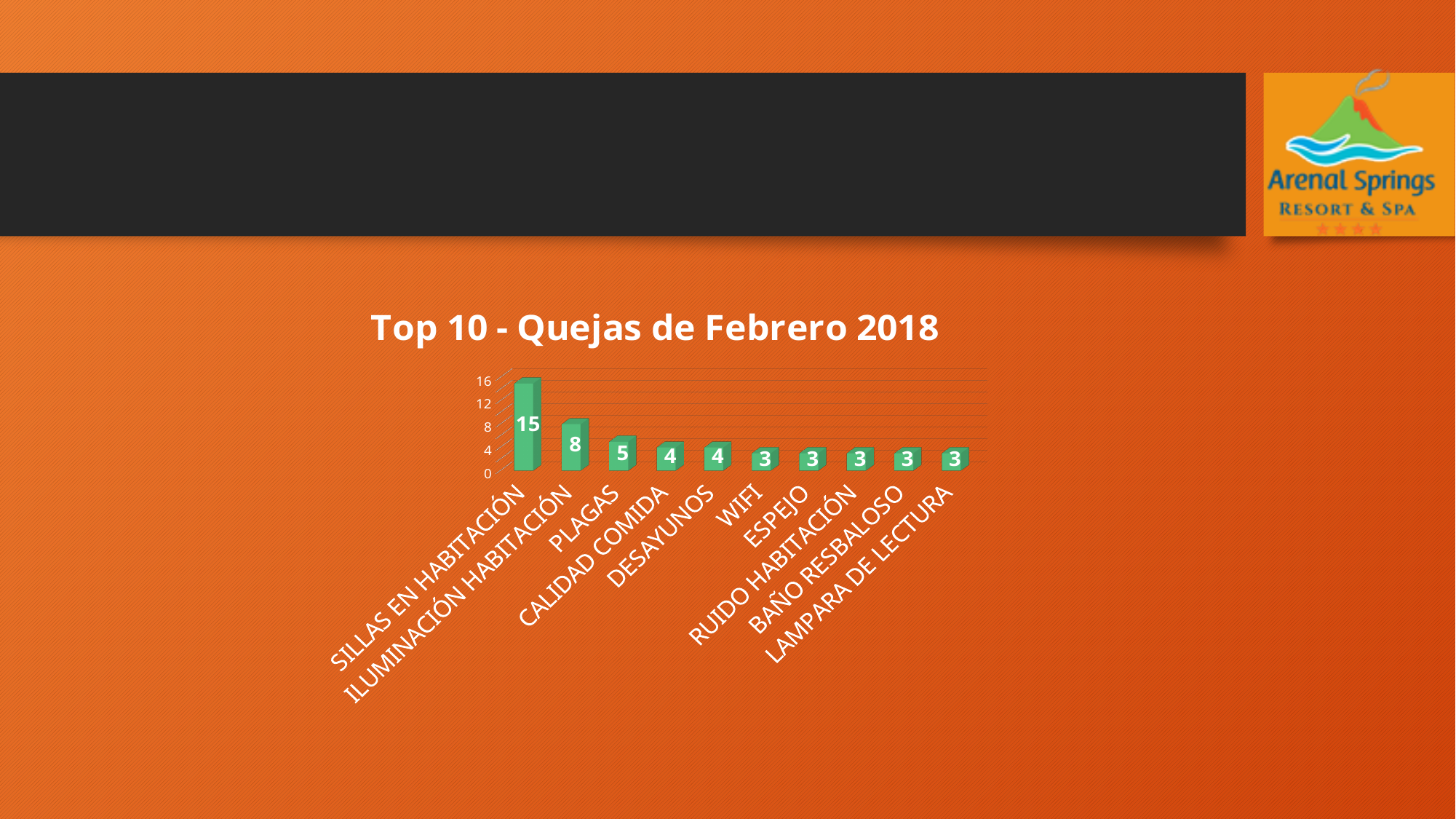
What is the title of the chart? Top 10 - Quejas de Febrero 2018 Which is larger, the value for PLAGAS or the value for DESAYUNOS? PLAGAS Do the values rise or fall from left to right along the x axis? fall What is the value for PLAGAS? 5 What is the value for ILUMINACIÓN HABITACIÓN? 8 Is the value for ILUMINACIÓN HABITACIÓN greater or less than 12? less What is the value for SILLAS EN HABITACIÓN? 15 How many categories are shown in the chart? 10 What kind of chart is shown on the slide? bar chart What is the difference between the values for SILLAS EN HABITACIÓN and ILUMINACIÓN HABITACIÓN? 7 Which category has the highest value? SILLAS EN HABITACIÓN What is the value for WIFI? 3